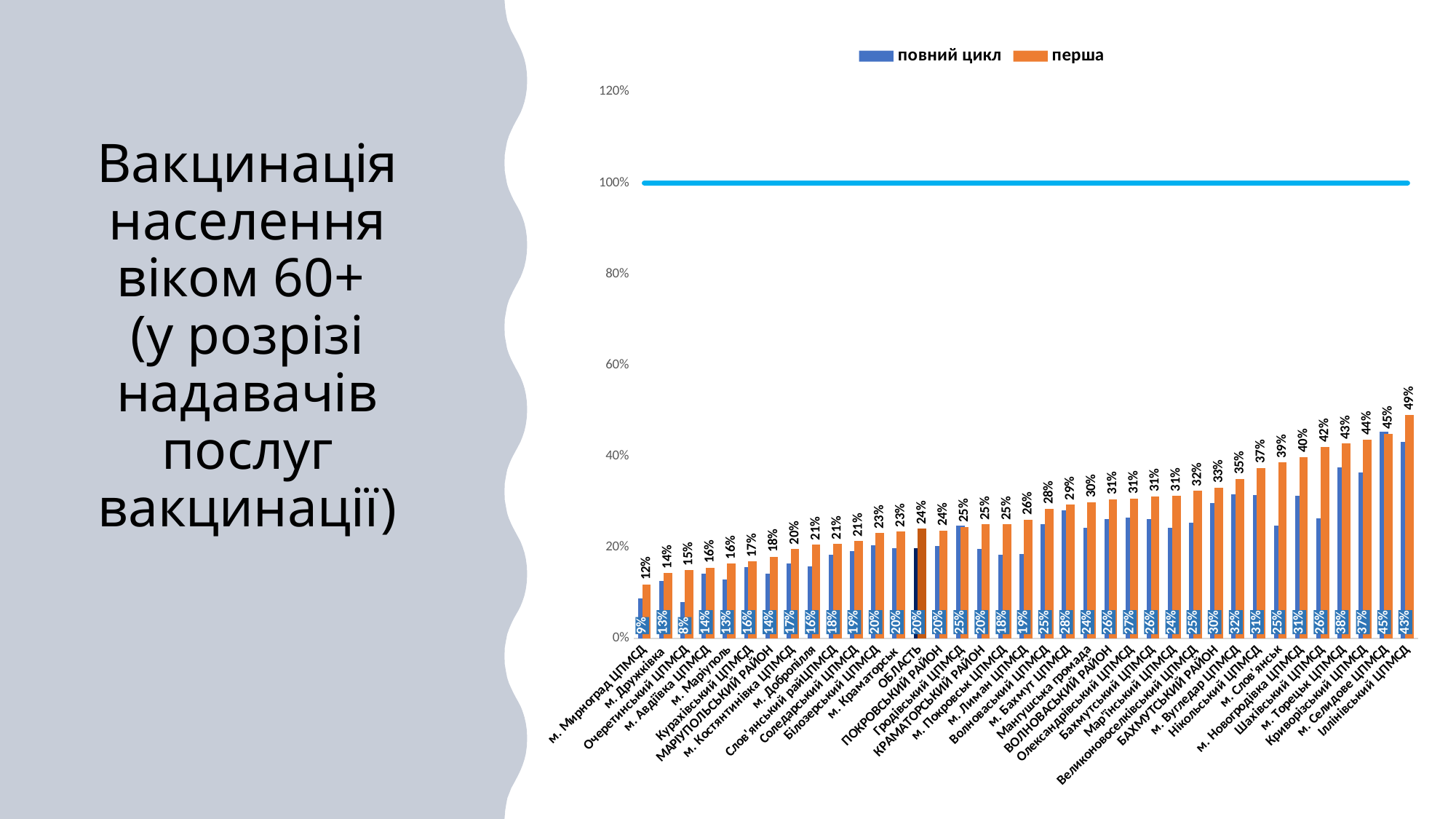
What are the two series named in the legend? повний цикл and перша Which category has the lowest value for the 'перша' series? м. Мирноград ЦПМСД What kind of chart is shown on the slide? bar chart What is the 'повний цикл' value for Іллінівський ЦПМСД? 43% How many providers (categories) are plotted along the x axis? 37 At what level is the horizontal blue reference line drawn on the chart? 100% What is the 'перша' value for ОБЛАСТЬ? 24% Do the 'перша' values rise or fall from left to right along the x axis? rise What is the difference between the 'перша' and 'повний цикл' values for Іллінівський ЦПМСД? 6 percentage points Which category has the highest value for the 'перша' series? Іллінівський ЦПМСД How many series does the legend list? 2 What is the 'перша' value for Іллінівський ЦПМСД? 49%